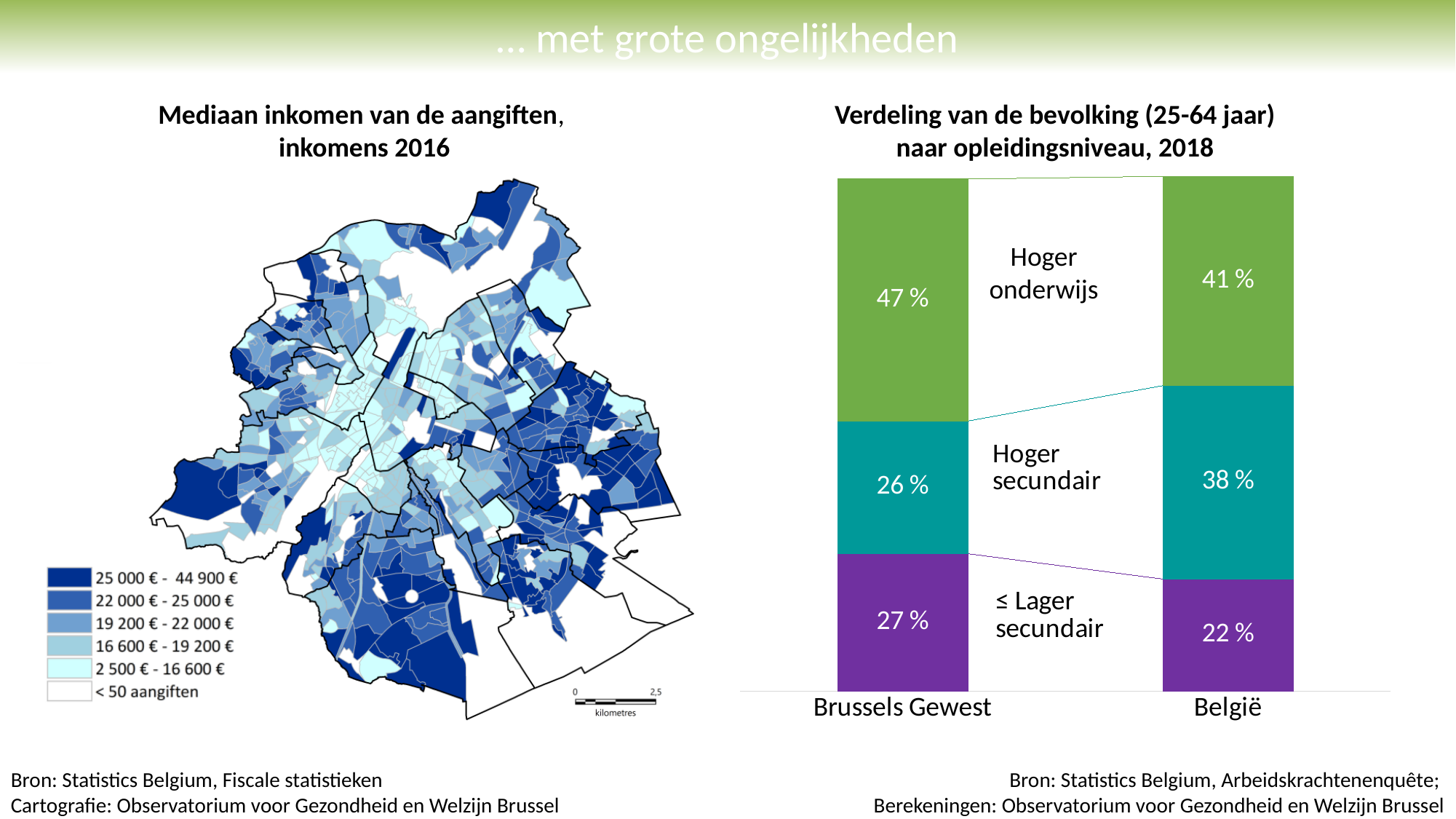
What kind of chart is shown on the right side of the slide, under the title 'Verdeling van de bevolking (25-64 jaar) naar opleidingsniveau, 2018'? Stacked bar chart In the chart 'Verdeling van de bevolking (25-64 jaar) naar opleidingsniveau, 2018', which education level has the largest share in Brussels Gewest? Hoger onderwijs In the chart 'Verdeling van de bevolking (25-64 jaar) naar opleidingsniveau, 2018', what share of the Brussels Gewest population has ≤ Lager secundair? 27 % In the chart 'Verdeling van de bevolking (25-64 jaar) naar opleidingsniveau, 2018', how many education levels are stacked in each bar? 3 In the chart 'Verdeling van de bevolking (25-64 jaar) naar opleidingsniveau, 2018', what share of the België population has Hoger secundair? 38 % In the chart 'Verdeling van de bevolking (25-64 jaar) naar opleidingsniveau, 2018', what share of the Brussels Gewest population has Hoger onderwijs? 47 % In the chart 'Verdeling van de bevolking (25-64 jaar) naar opleidingsniveau, 2018', what share of the België population has ≤ Lager secundair? 22 % In the chart 'Verdeling van de bevolking (25-64 jaar) naar opleidingsniveau, 2018', what is the difference in the Hoger onderwijs share between Brussels Gewest and België? 6 % In the chart 'Verdeling van de bevolking (25-64 jaar) naar opleidingsniveau, 2018', which education level has the smallest share in België? ≤ Lager secundair In the chart 'Verdeling van de bevolking (25-64 jaar) naar opleidingsniveau, 2018', which region has the larger share of ≤ Lager secundair, Brussels Gewest or België? Brussels Gewest In the chart 'Verdeling van de bevolking (25-64 jaar) naar opleidingsniveau, 2018', how many regions are shown as bars? 2 In the chart 'Verdeling van de bevolking (25-64 jaar) naar opleidingsniveau, 2018', what is the difference in the Hoger secundair share between België and Brussels Gewest? 12 %